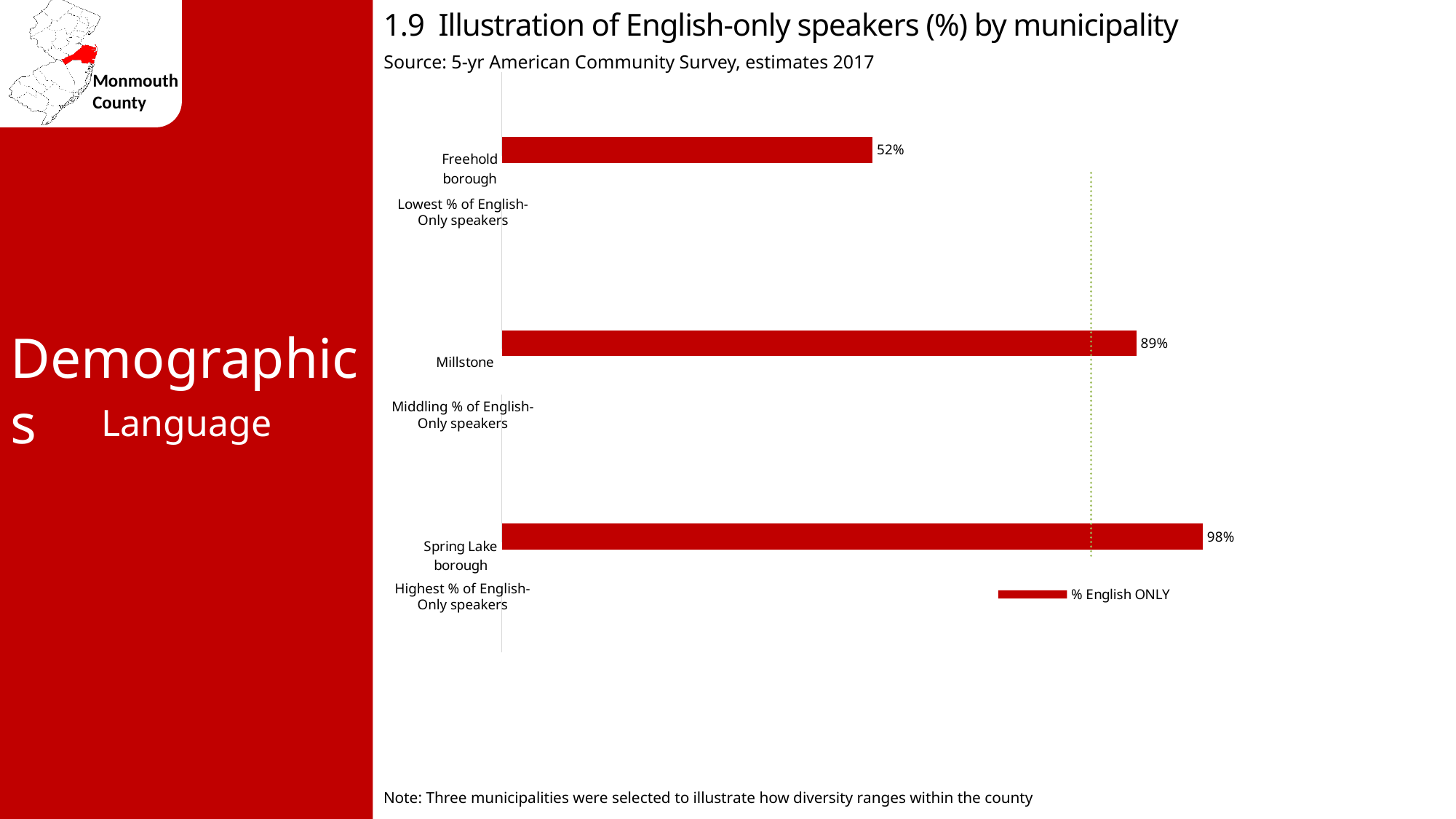
How many series does the legend list? 1 Which municipality has the highest percentage of English-only speakers? Spring Lake borough What is the difference in percentage of English-only speakers between Spring Lake borough and Freehold borough? 46% What is the name of the series shown in the legend? % English ONLY What is the percentage of English-only speakers in Freehold borough? 52% What is the percentage of English-only speakers in Millstone? 89% What is the percentage of English-only speakers in Spring Lake borough? 98% Which has a higher percentage of English-only speakers, Millstone or Freehold borough? Millstone How many municipalities are shown in the chart? 3 What is the difference in percentage of English-only speakers between Millstone and Freehold borough? 37% Which municipality has the lowest percentage of English-only speakers? Freehold borough What kind of chart is shown on the slide? Bar chart